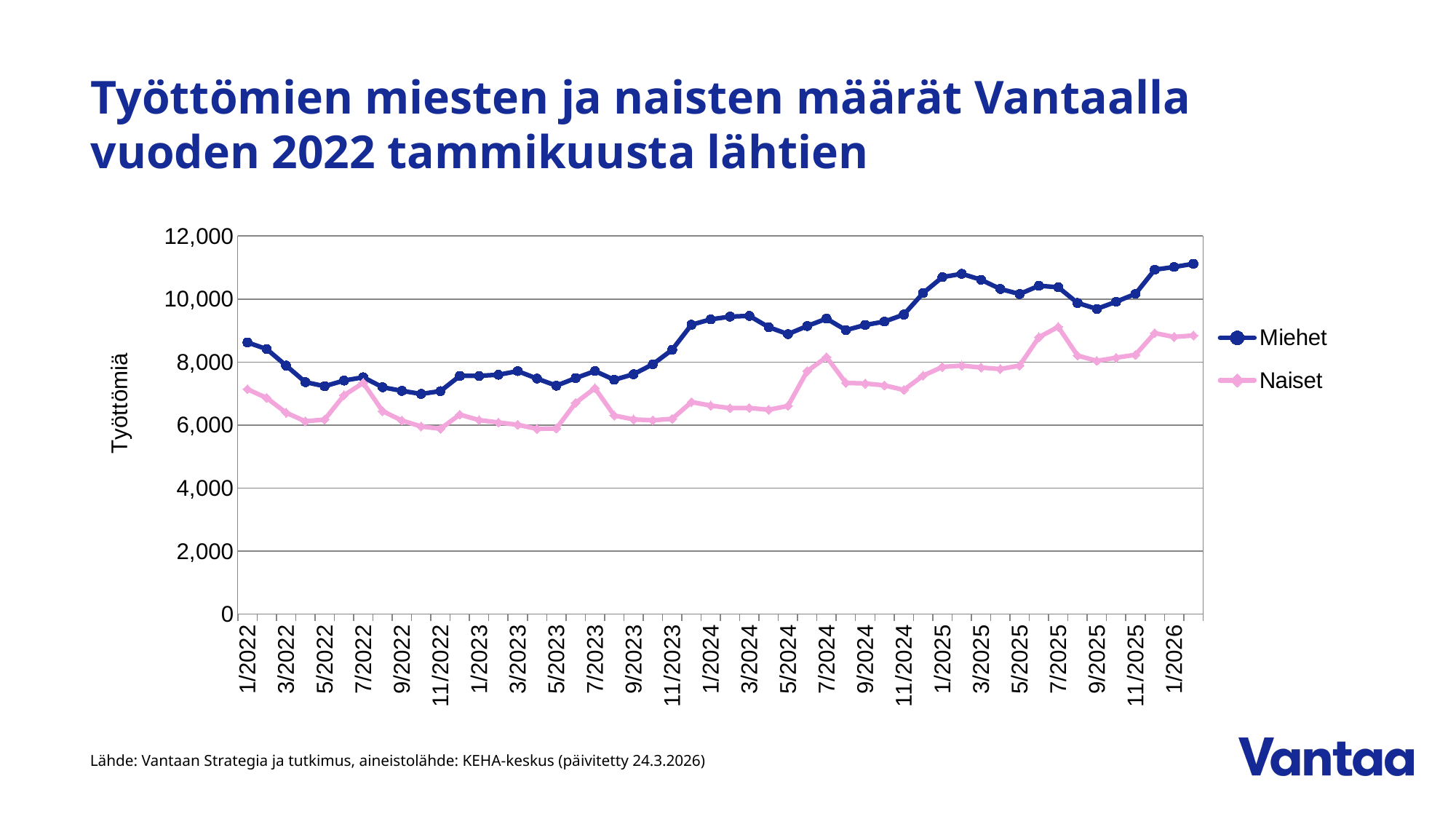
Is the value for Miehet in 9/2025 greater or less than 10,000? less Overall, do the values for Miehet rise or fall from 1/2022 to 1/2026? Rise What is the label on the vertical axis? Työttömiä Is the value for Naiset in 1/2022 greater or less than 8,000? less Is the value for Miehet in 1/2022 greater or less than 8,000? greater How many series does the legend list? 2 Which series has the higher value in 1/2026, Miehet or Naiset? Miehet What are the two series named in the legend? Miehet and Naiset What kind of chart is shown on the slide? Line chart